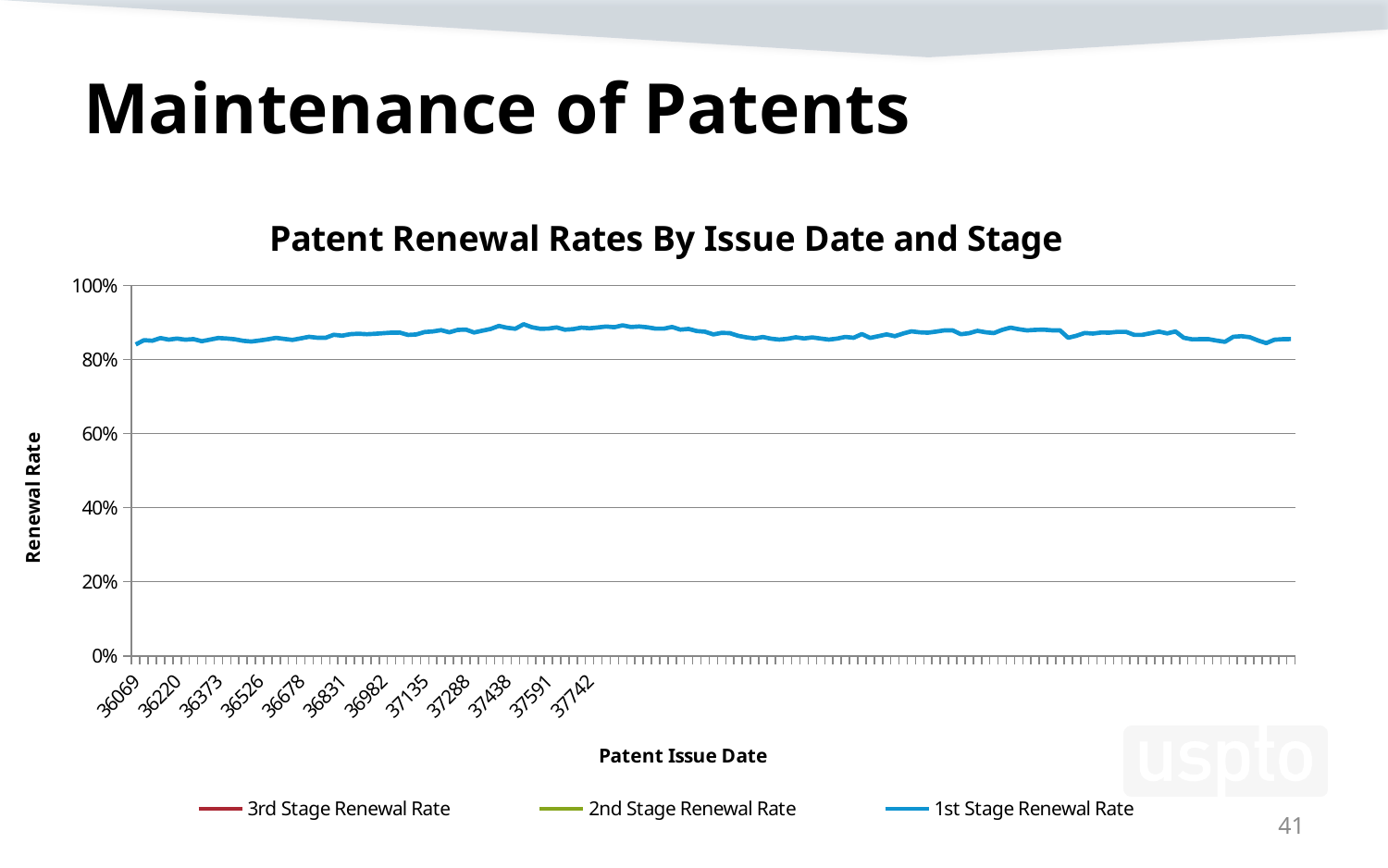
What is the first issue date label shown on the horizontal axis? 36069 Is the 1st Stage Renewal Rate at issue date 37742 greater or less than 60%? greater How many series does the chart legend list? 3 Does the 1st Stage Renewal Rate line ever fall below 80% across the chart? No What is the highest value shown on the vertical axis? 100% Is the 1st Stage Renewal Rate at issue date 36069 greater or less than 80%? greater What kind of chart is shown on the slide? Line chart What is the title of the chart? Patent Renewal Rates By Issue Date and Stage Which series is drawn in blue according to the legend? 1st Stage Renewal Rate What is the label of the vertical axis? Renewal Rate What is the label of the horizontal axis? Patent Issue Date